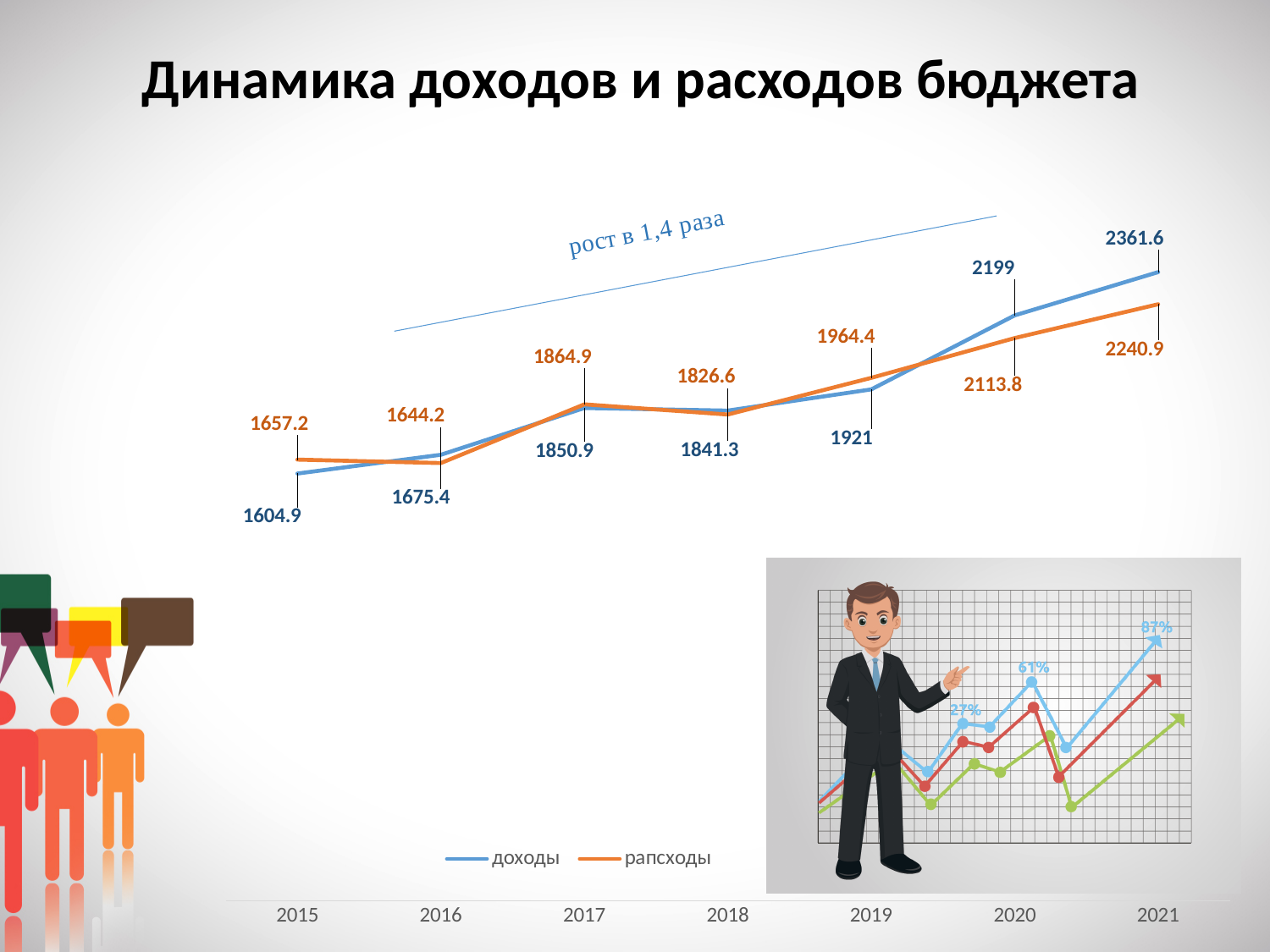
Which is larger in 2019, доходы or рапсходы? рапсходы What is the value of доходы in 2015? 1604.9 How many series does the legend list? 2 What is the value of рапсходы in 2019? 1964.4 What is the value of рапсходы in 2020? 2113.8 Do the доходы values generally rise or fall from 2015 to 2021? rise What is the difference between доходы and рапсходы in 2021? 120.7 What kind of chart is shown on the slide? line chart What is the value of доходы in 2021? 2361.6 In which year is рапсходы lowest? 2016 How many years are plotted on the x axis? 7 In which year is доходы highest? 2021